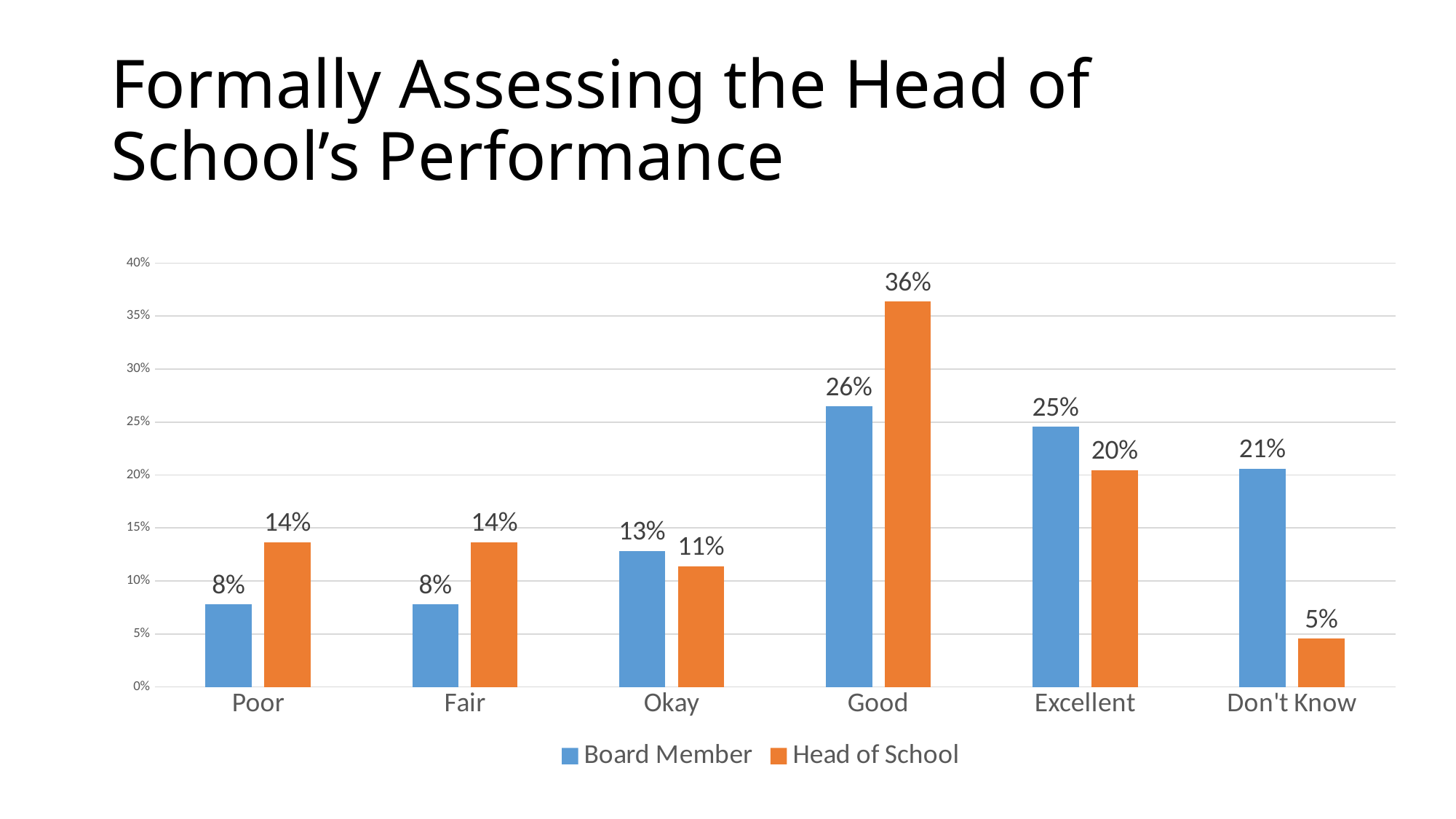
How many categories are shown on the x axis? 6 What is the difference between the Head of School and Board Member values for Good? 10% Which category has the lowest Head of School value? Don't Know What is the Board Member value for Don't Know? 21% Which category has the highest Head of School value? Good What kind of chart is shown on the slide? Bar chart What colour are the Head of School bars? Orange What is the Head of School value for Don't Know? 5% What is the Head of School value for Good? 36% Which is larger for Excellent: the Board Member value or the Head of School value? Board Member How many series does the legend list? 2 What is the Board Member value for Okay? 13%